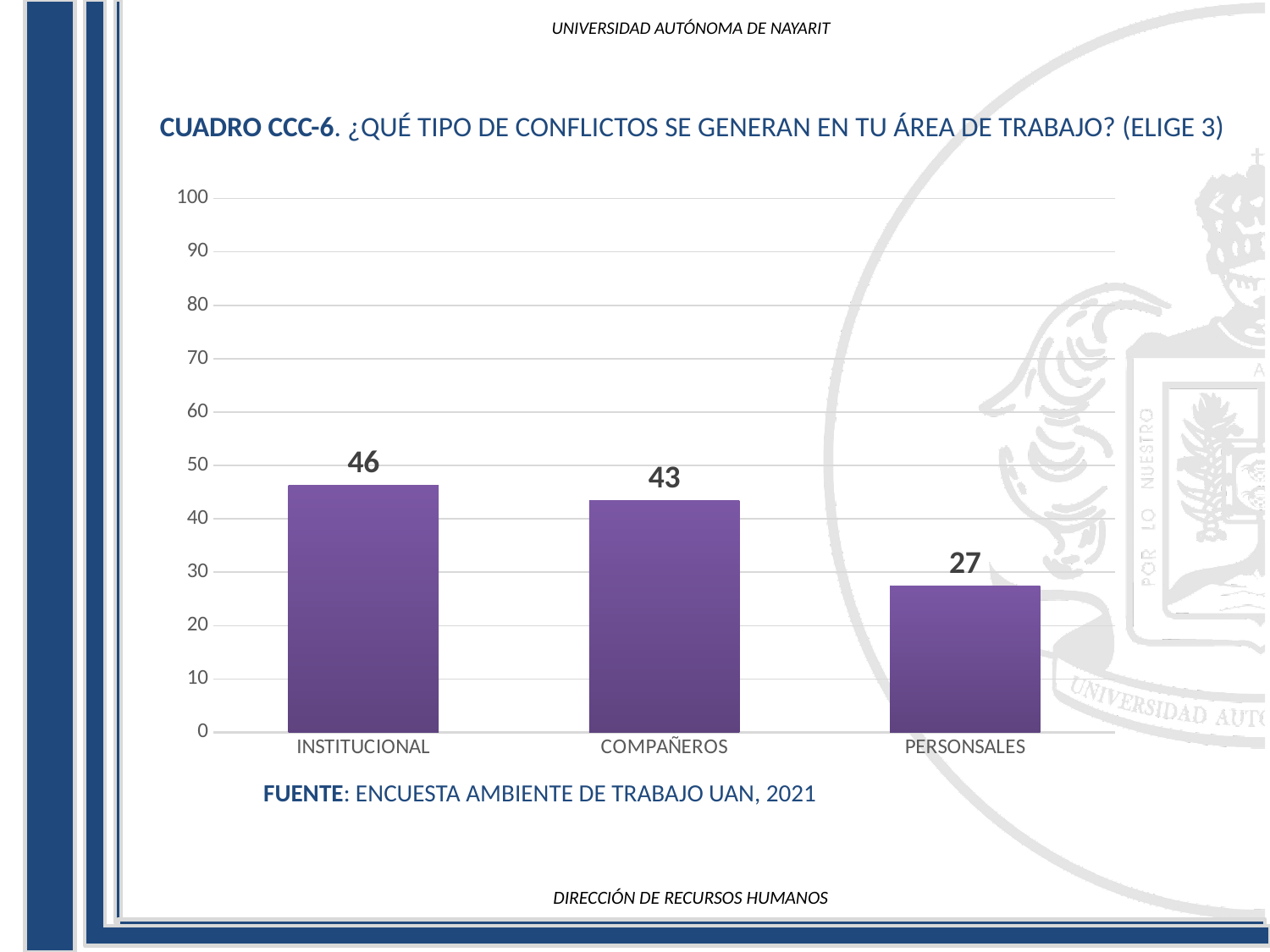
Which is larger, the value for COMPAÑEROS or the value for PERSONSALES? COMPAÑEROS What kind of chart is shown on the slide? bar chart What is the value for INSTITUCIONAL? 46 How many categories are shown on the x axis? 3 What is the value for PERSONSALES? 27 Is the value for INSTITUCIONAL greater or less than 50? less Which category has the lowest value? PERSONSALES What is the difference between the values for COMPAÑEROS and PERSONSALES? 16 Which category has the highest value? INSTITUCIONAL What source is cited below the chart? ENCUESTA AMBIENTE DE TRABAJO UAN, 2021 What is the value for COMPAÑEROS? 43 What is the difference between the values for INSTITUCIONAL and PERSONSALES? 19